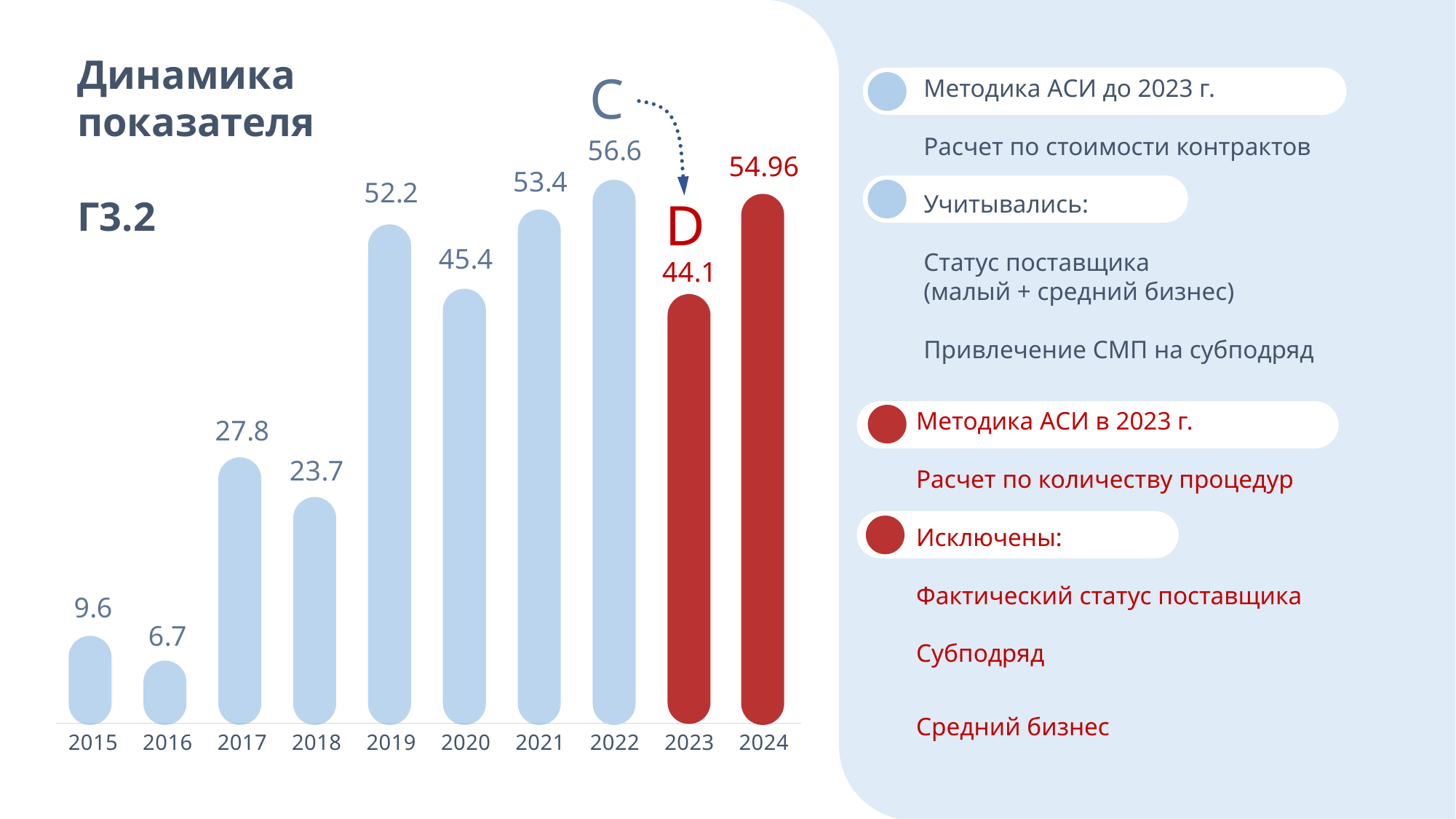
What is the value for 2024? 54.96 What is the value for 2019? 52.2 What is the difference between the values for 2022 and 2023? 12.5 Which year has the highest value? 2022 What kind of chart is this? bar chart How many years are shown on the x axis? 10 Which years are shown with red bars? 2023 and 2024 Which year has the lowest value? 2016 What is the difference between the values for 2020 and 2021? 8 Which is larger, the value for 2017 or the value for 2018? 2017 What is the value for 2016? 6.7